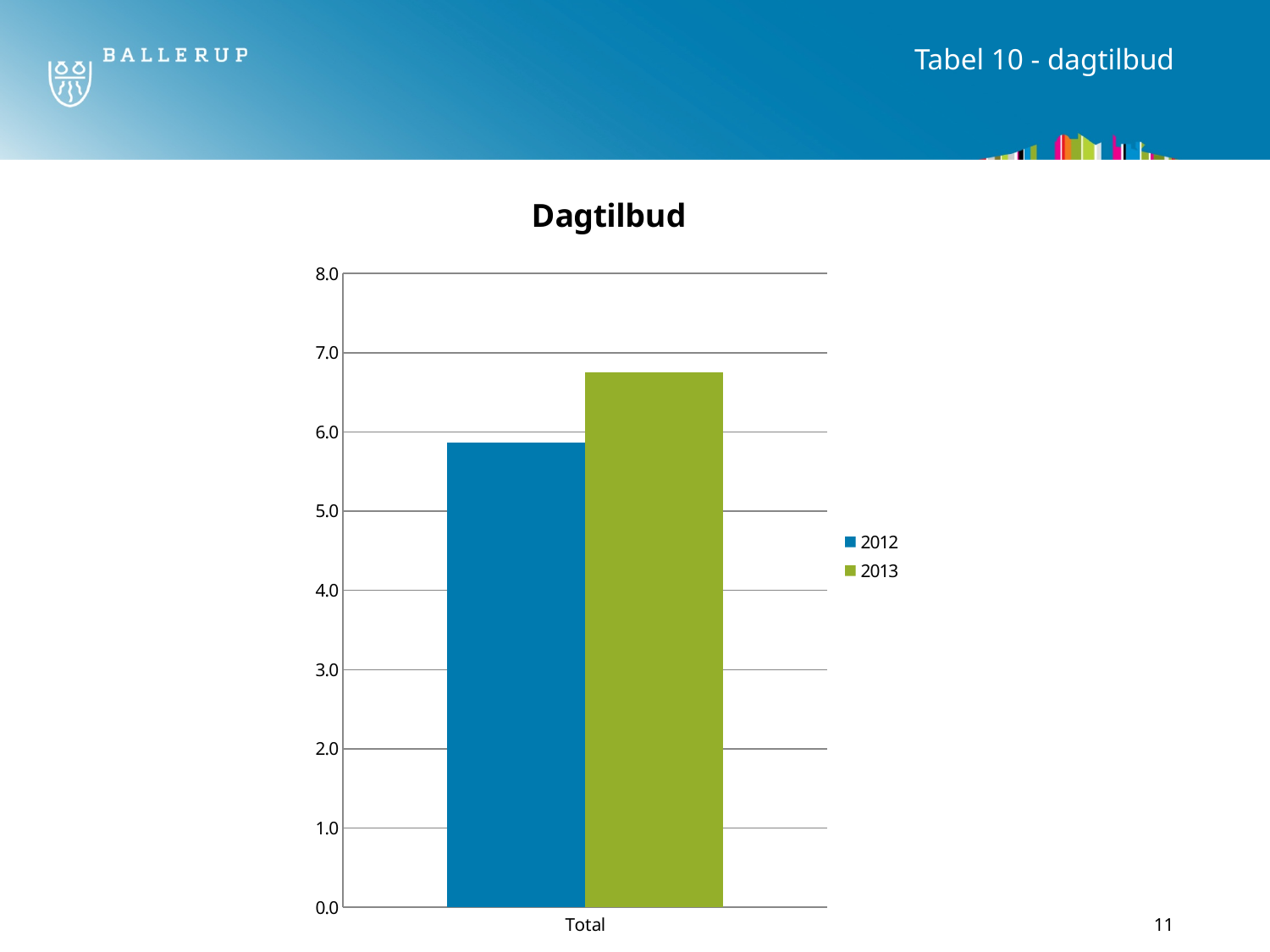
What is the title of the chart? Dagtilbud Is the value for 2013 greater or less than 6.0? greater What is the maximum value shown on the y axis? 8.0 Is the value for 2012 greater or less than 6.0? less What is the label of the category on the x axis? Total How many series does the legend list? 2 Is the value for 2012 greater or less than 5.0? greater Which series are listed in the legend? 2012 and 2013 How many categories are shown on the x axis? 1 Which series has the higher value for Total, 2012 or 2013? 2013 What kind of chart is shown on the slide? bar chart